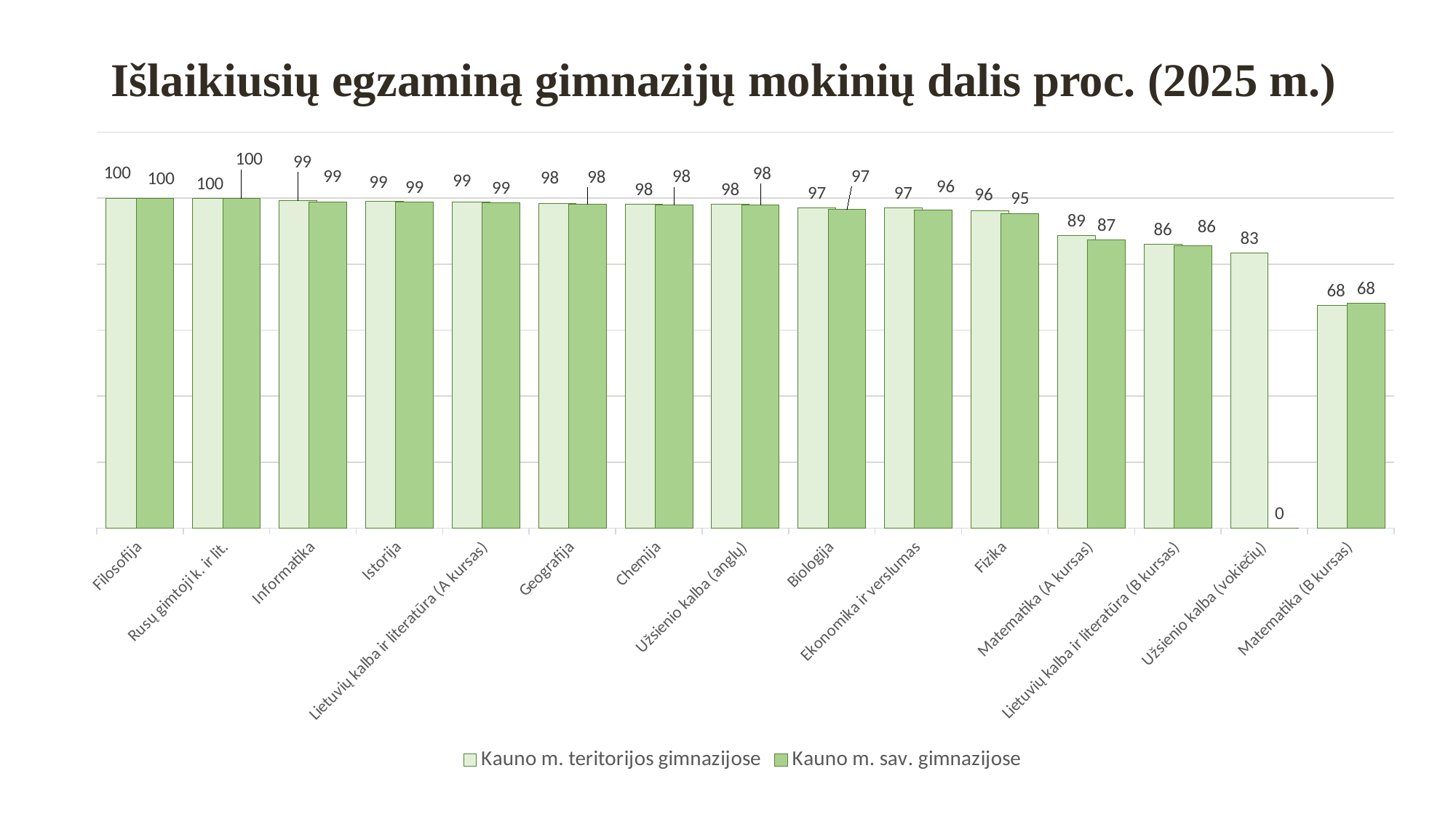
What kind of chart is shown on the slide? bar chart What is the value for Matematika (A kursas) in the Kauno m. teritorijos gimnazijose series? 89 What is the value for Fizika in the Kauno m. sav. gimnazijose series? 95 Which category has the lowest value in the Kauno m. sav. gimnazijose series? Užsienio kalba (vokiečių) How many categories are shown on the x axis? 15 What is the difference between the Kauno m. teritorijos gimnazijose value and the Kauno m. sav. gimnazijose value for Užsienio kalba (vokiečių)? 83 What is the difference between the Kauno m. teritorijos gimnazijose value for Filosofija and for Matematika (B kursas)? 32 Which is larger: the Kauno m. teritorijos gimnazijose value for Matematika (A kursas) or for Lietuvių kalba ir literatūra (B kursas)? Matematika (A kursas) Which category has the lowest value in the Kauno m. teritorijos gimnazijose series? Matematika (B kursas) What is the value for Užsienio kalba (vokiečių) in the Kauno m. sav. gimnazijose series? 0 What is the value for Matematika (A kursas) in the Kauno m. sav. gimnazijose series? 87 How many series does the legend list? 2